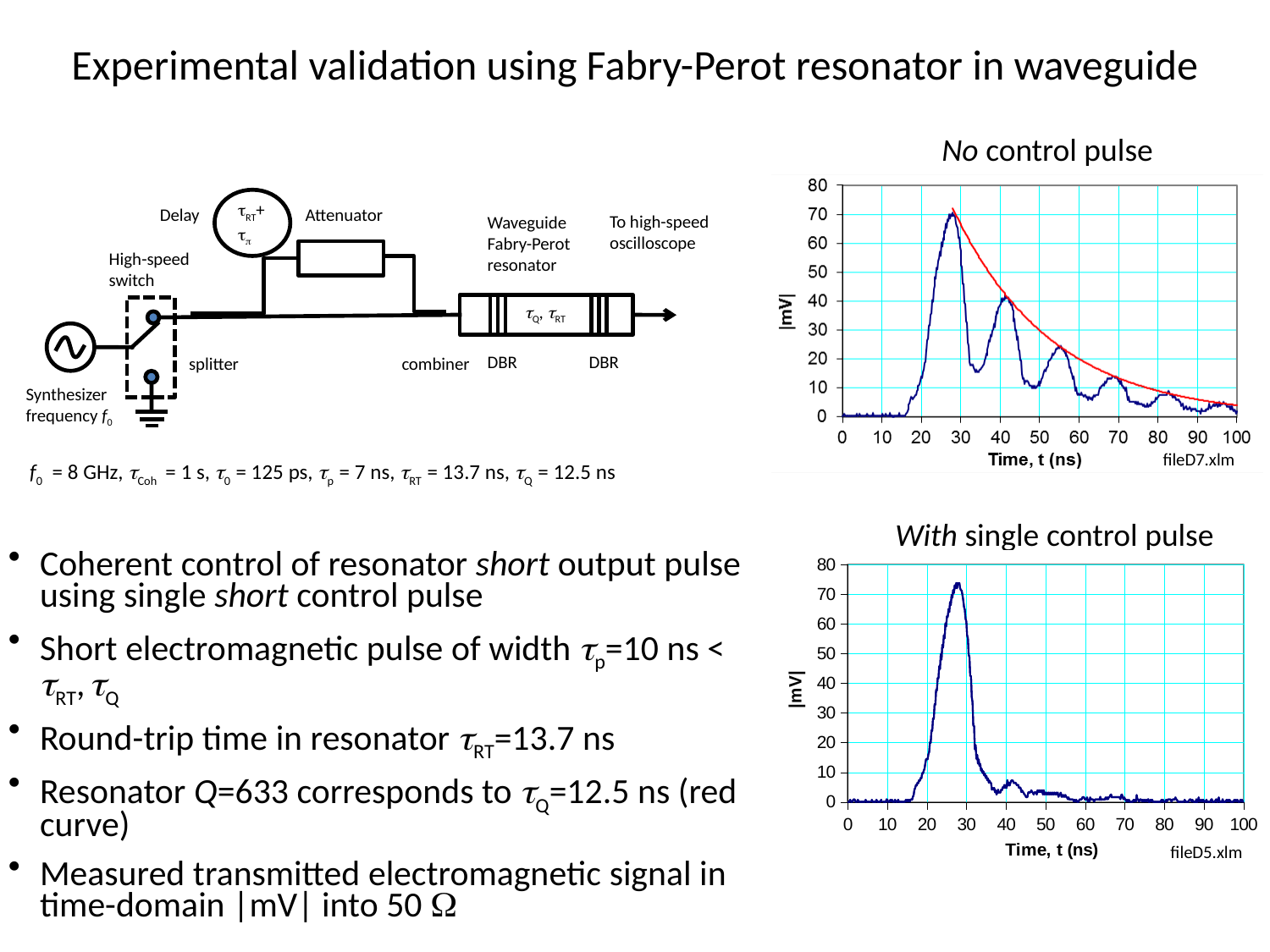
How many curves are plotted in the 'No control pulse' chart? 2 In the 'No control pulse' chart, what is the label of the x axis? Time, t (ns) In the 'With single control pulse' chart, is the peak value greater or less than 60? greater In the 'With single control pulse' chart, is the value at t = 60 ns greater or less than 10? less What kind of chart is the 'With single control pulse' chart? line chart In the 'No control pulse' chart, is the peak value of the blue curve greater or less than 60? greater In the 'No control pulse' chart, does the red curve rise or fall as time increases from 30 ns to 100 ns? fall What kind of chart is the 'No control pulse' chart? line chart In the 'With single control pulse' chart, what is the label of the y axis? |mV| What is the highest tick value shown on the x axis of the 'With single control pulse' chart? 100